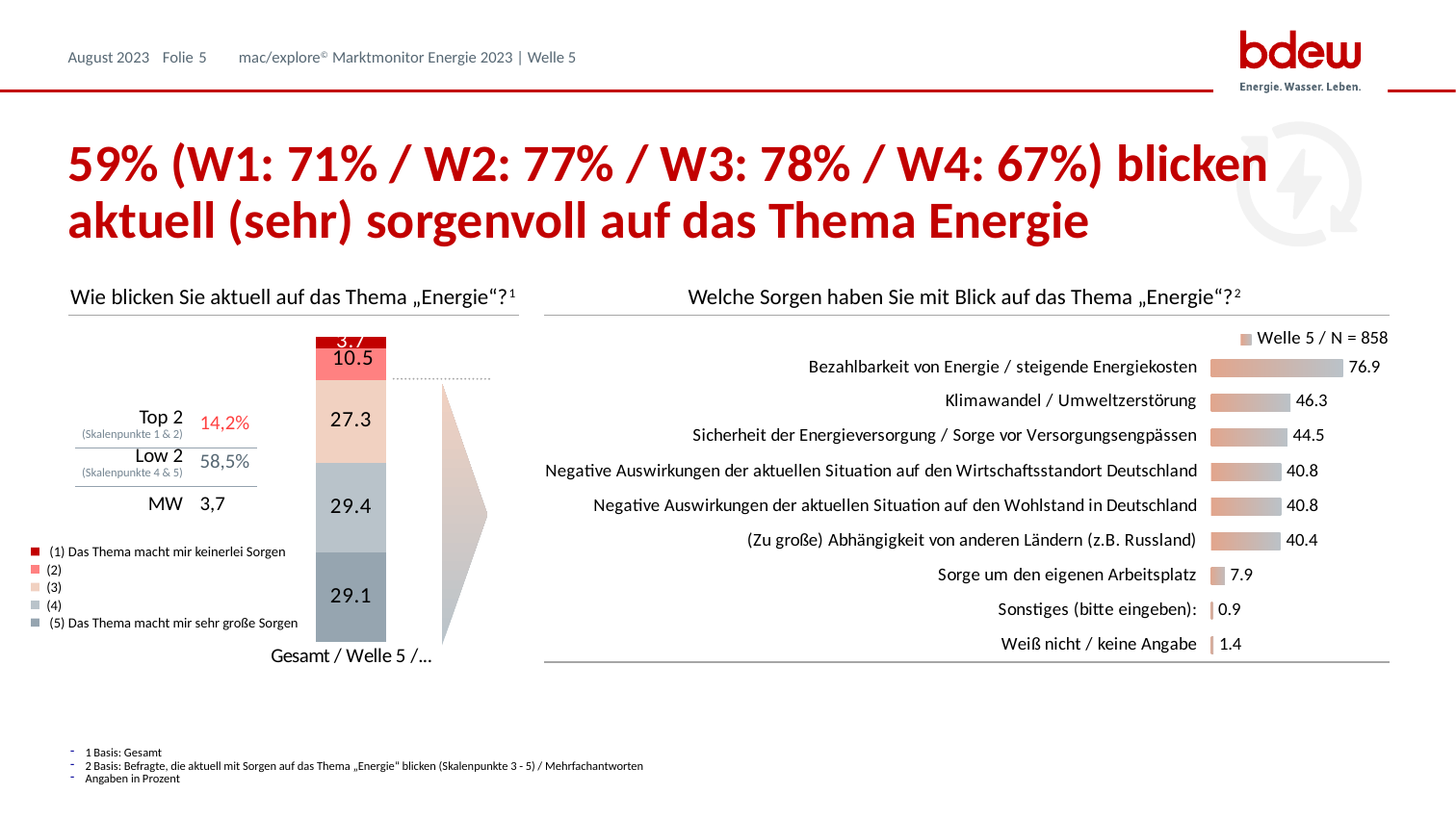
How many entries does the legend of the left chart list? 5 In the right chart, what is the value for "Klimawandel / Umweltzerstörung"? 46.3 What is the sample size (N) shown in the legend of the right chart? 858 In the right chart, what is the value for "Sorge um den eigenen Arbeitsplatz"? 7.9 In the right chart, which is larger: "Sicherheit der Energieversorgung / Sorge vor Versorgungsengpässen" or "(Zu große) Abhängigkeit von anderen Ländern (z.B. Russland)"? Sicherheit der Energieversorgung / Sorge vor Versorgungsengpässen In the left chart ("Wie blicken Sie aktuell auf das Thema „Energie“?"), what is the value of the segment for "(5) Das Thema macht mir sehr große Sorgen"? 29.1 In the right chart ("Welche Sorgen haben Sie mit Blick auf das Thema „Energie“?"), what is the value for "Bezahlbarkeit von Energie / steigende Energiekosten"? 76.9 In the right chart, what is the difference between "Bezahlbarkeit von Energie / steigende Energiekosten" and "Klimawandel / Umweltzerstörung"? 30.6 In the right chart, which category has the lowest value? Sonstiges (bitte eingeben): How many categories are shown in the right chart? 9 In the right chart, which category has the highest value? Bezahlbarkeit von Energie / steigende Energiekosten What type of chart is the right chart? Bar chart